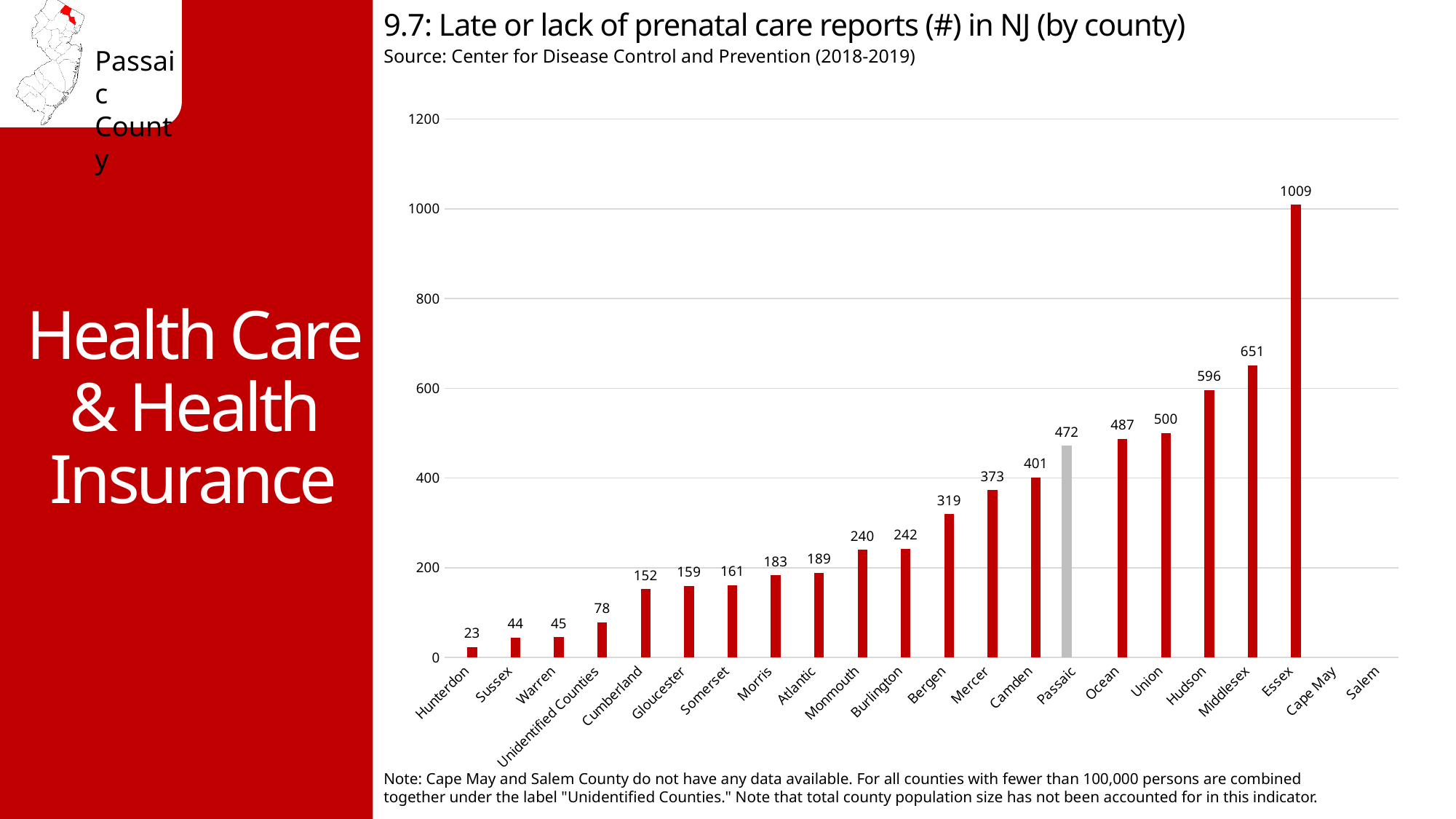
Which county has the highest number of late or lack of prenatal care reports? Essex Which is larger, the value for Ocean or the value for Union? Union What is the value for Unidentified Counties? 78 What is the difference between the values for Essex and Middlesex? 358 What kind of chart is shown on the slide? bar chart What is the value for Passaic? 472 What is the difference between the values for Passaic and Camden? 71 Which bar is coloured grey instead of red? Passaic Is the value for Bergen greater or less than 400? less How many category labels are shown on the x axis? 22 What is the value for Hudson? 596 Among the counties with a plotted bar, which has the lowest value? Hunterdon